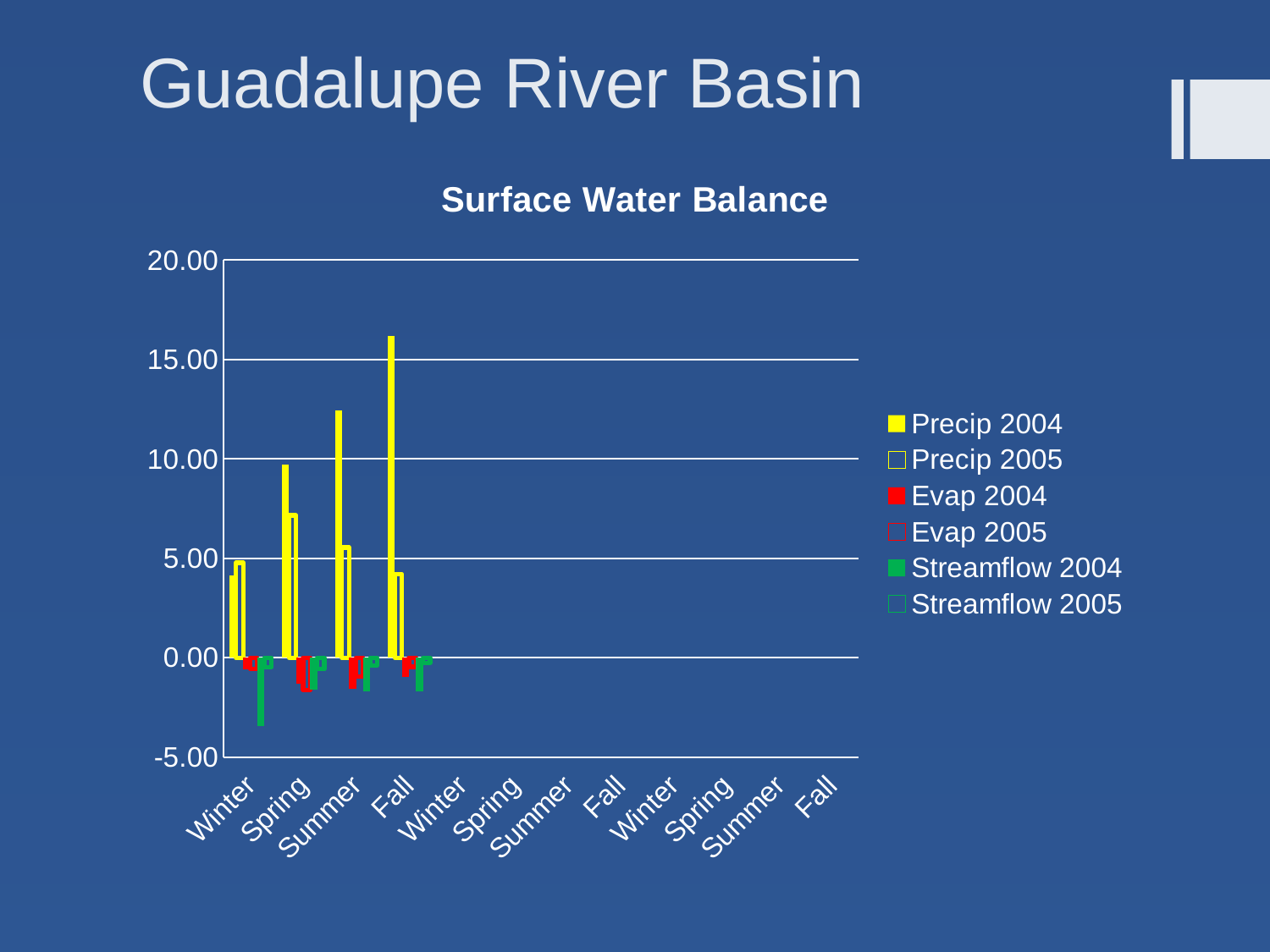
Which season has the highest Precip 2004 value? Fall Is the Precip 2004 value for Summer greater or less than 10.00? greater How many series does the legend list? 6 Is the Precip 2004 value for Winter greater or less than 5.00? less Which season has the lowest Precip 2004 value? Winter Do the Precip 2004 values rise or fall from Winter to Fall in the first group of seasons? rise What is the title of the chart? Surface Water Balance Is the Precip 2005 value for Spring greater or less than 5.00? greater Which is larger, the Precip 2004 value for Summer or for Spring? Summer How many category labels are shown along the x axis? 12 What kind of chart is shown on the slide? bar chart